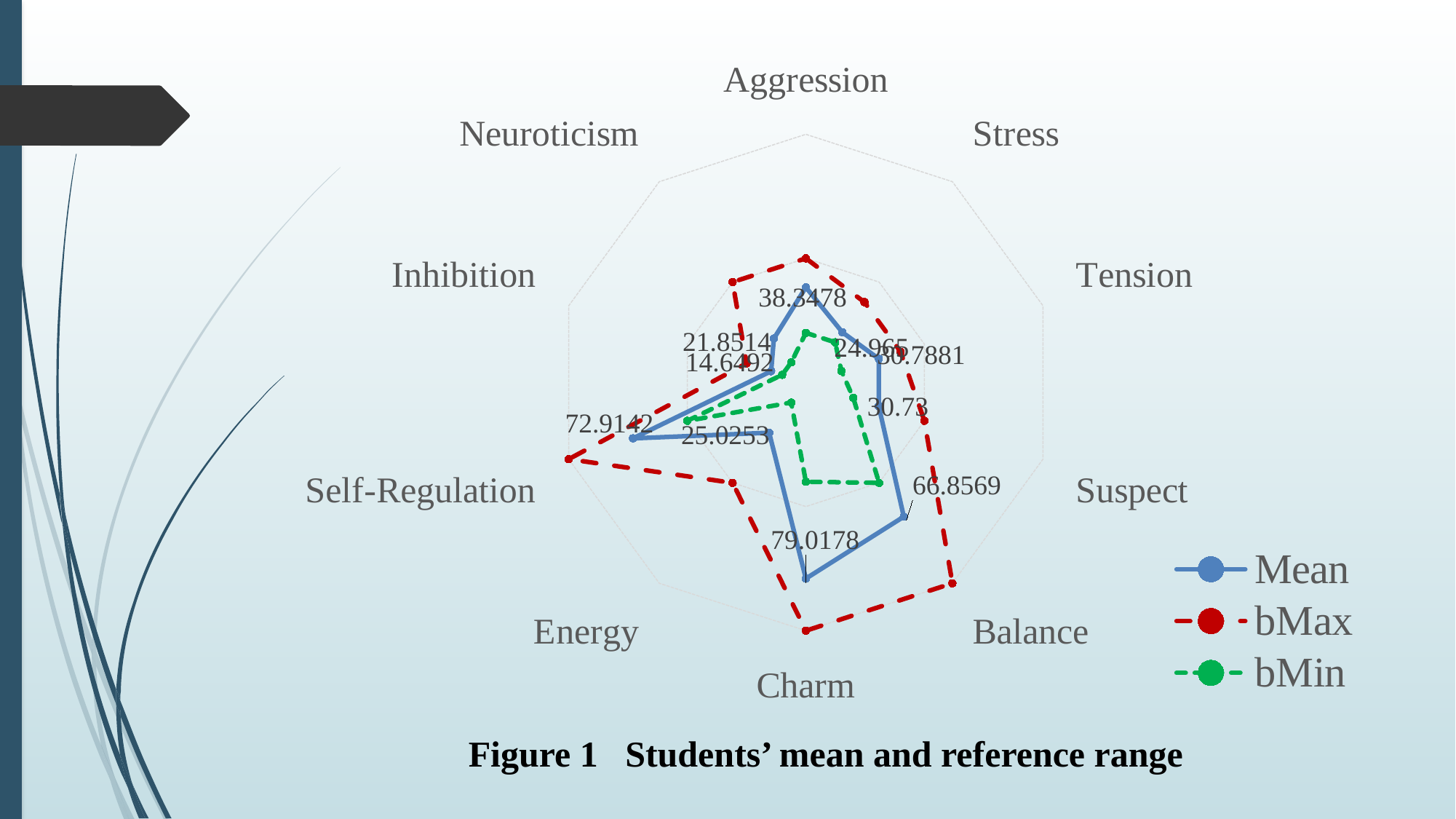
What is the Mean value for Aggression? 38.3478 What kind of chart is shown on the slide? Radar chart What is the Mean value for Charm? 79.0178 What is the Mean value for Self-Regulation? 72.9142 How many series does the legend list? 3 How many categories (axes) does the radar chart have? 10 What is the caption of the figure? Figure 1 Students' mean and reference range What is the Mean value for Energy? 25.0253 Which category has the highest Mean value? Charm What is the Mean value for Balance? 66.8569 What is the difference between the Mean values for Charm and Balance? 12.1609 Which is larger, the Mean value for Self-Regulation or for Energy? Self-Regulation